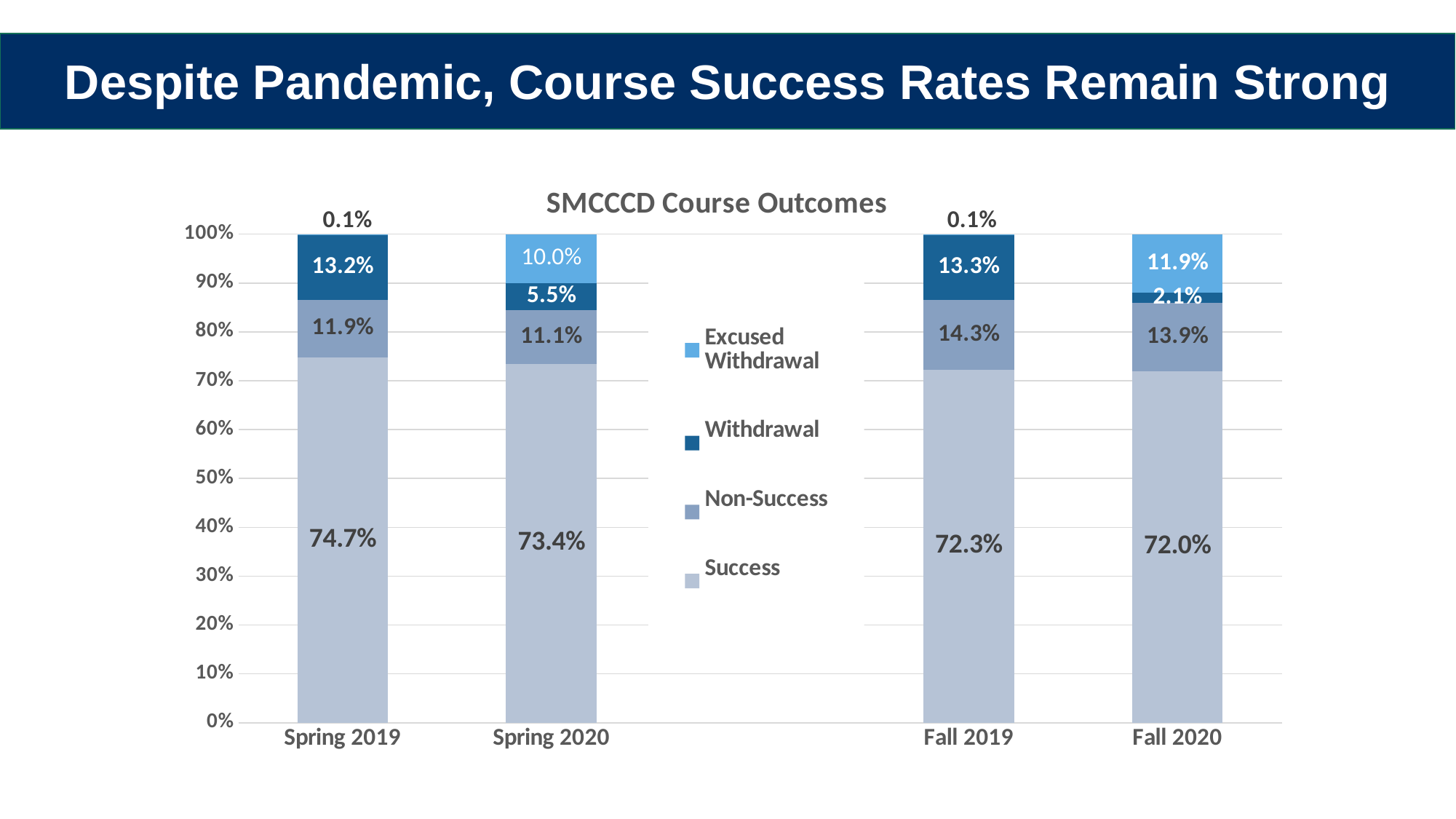
Which term has the highest Success rate? Spring 2019 Which term has the lowest Success rate? Fall 2020 What is the Non-Success share for Fall 2019? 14.3% What is the Success rate for Spring 2019? 74.7% How many series does the legend list? 4 How many terms are shown on the x axis? 4 What is the difference between the Success rates for Spring 2019 and Spring 2020? 1.3% What is the Excused Withdrawal share for Fall 2020? 11.9% What is the title of the chart? SMCCCD Course Outcomes What is the Withdrawal share for Spring 2020? 5.5% Which is larger, the Non-Success share for Fall 2019 or for Fall 2020? Fall 2019 What kind of chart is this? Stacked bar chart